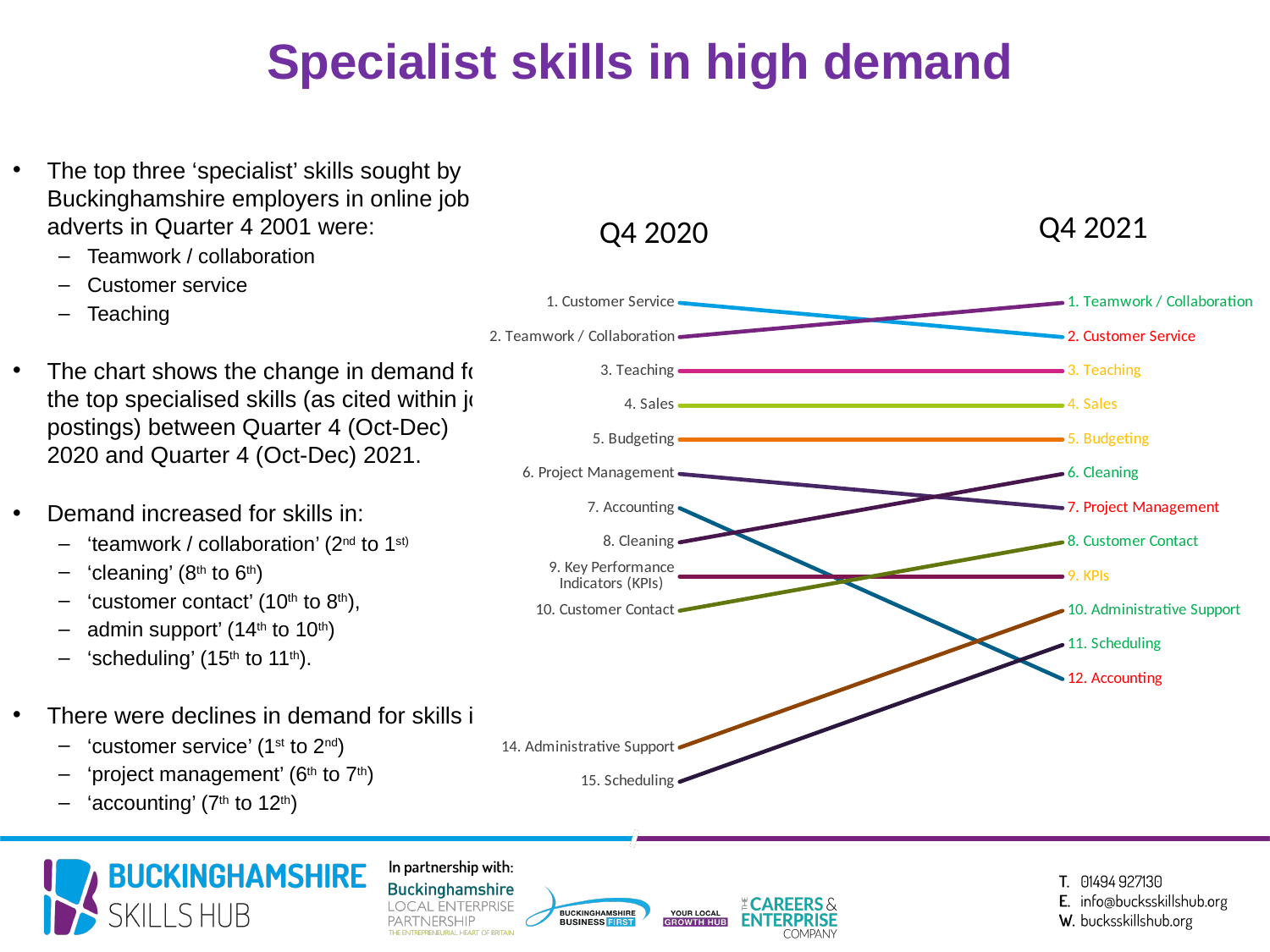
What rank did Accounting hold in Q4 2021 on the chart? 12 What kind of chart is shown on the slide? Slope (line) chart What are the two column headings shown above the chart? Q4 2020 and Q4 2021 By how many places did Administrative Support's rank change between Q4 2020 and Q4 2021? 4 Which skill was ranked lowest (15th) in Q4 2020 on the chart? Scheduling What rank did Customer Service hold in Q4 2020 on the chart? 1 By how many places did Accounting's rank change between Q4 2020 and Q4 2021? 5 Did Cleaning's rank improve or decline from Q4 2020 to Q4 2021? Improve What rank did Scheduling hold in Q4 2020 on the chart? 15 What rank did Teamwork / Collaboration hold in Q4 2021 on the chart? 1 How many skills are plotted as lines on the chart? 12 What rank did Administrative Support hold in Q4 2020 on the chart? 14